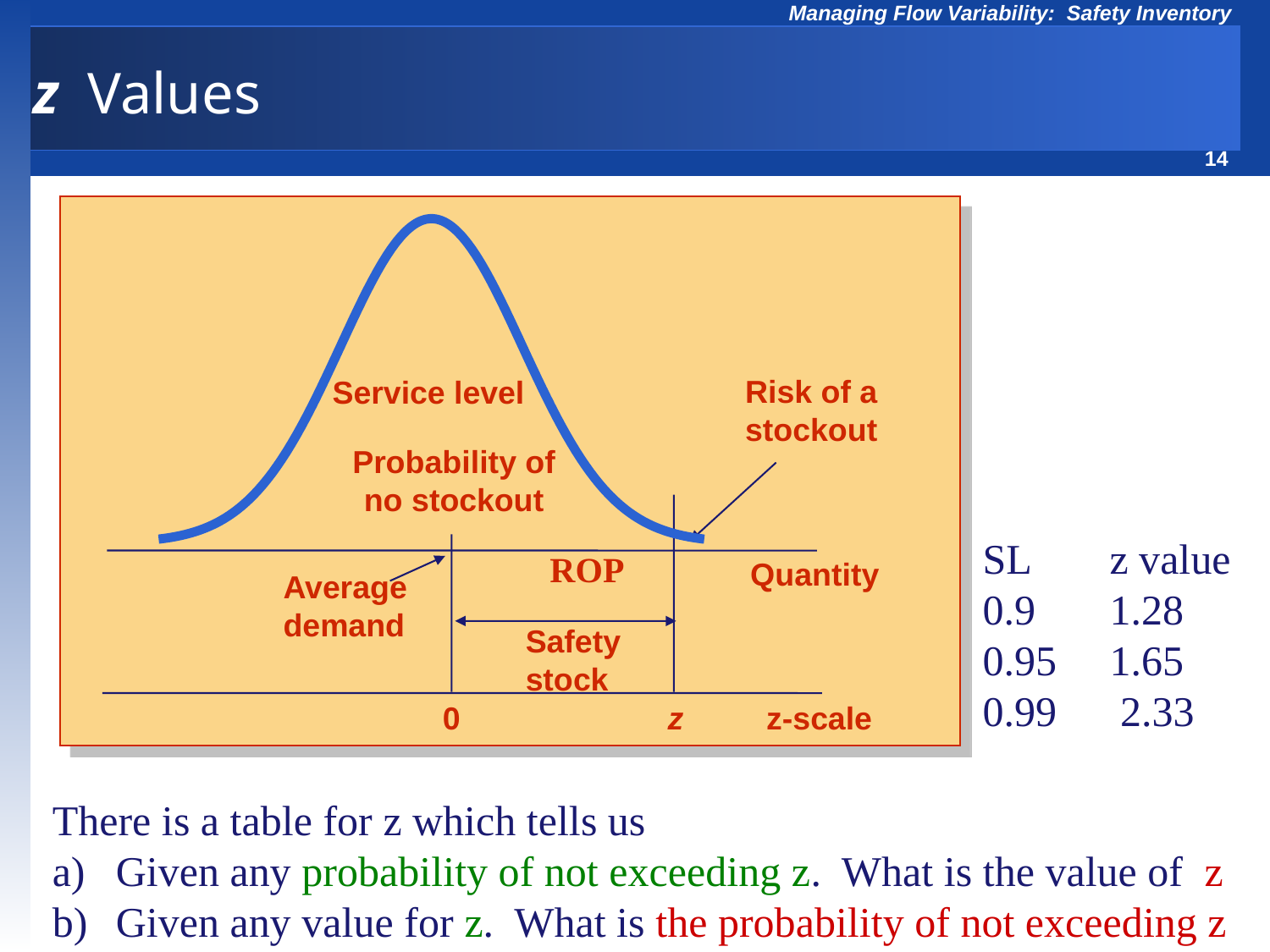
What does the arrow pointing to the right tail of the curve label? Risk of a stockout In the SL / z value table beside the diagram, which SL has the highest z value? 0.99 Moving from left to right along the x axis, does the curve rise or fall after its peak? fall In the SL / z value table beside the diagram, what is the difference between the z values for SL 0.99 and SL 0.95? 0.68 What does the area under the curve to the left of z represent, according to the labels in the diagram? Service level (Probability of no stockout) In the SL / z value table beside the diagram, what is the z value for SL 0.9? 1.28 In the SL / z value table beside the diagram, is the z value for SL 0.95 larger or smaller than the z value for SL 0.9? larger What kind of chart is shown in the diagram on the slide? line chart (bell curve) What label is printed at the left tick of the z-scale axis, under the average demand line? 0 In the SL / z value table beside the diagram, which SL has the lowest z value? 0.9 In the SL / z value table beside the diagram, what is the z value for SL 0.95? 1.65 How many tick labels are printed on the z-scale axis of the diagram? 2